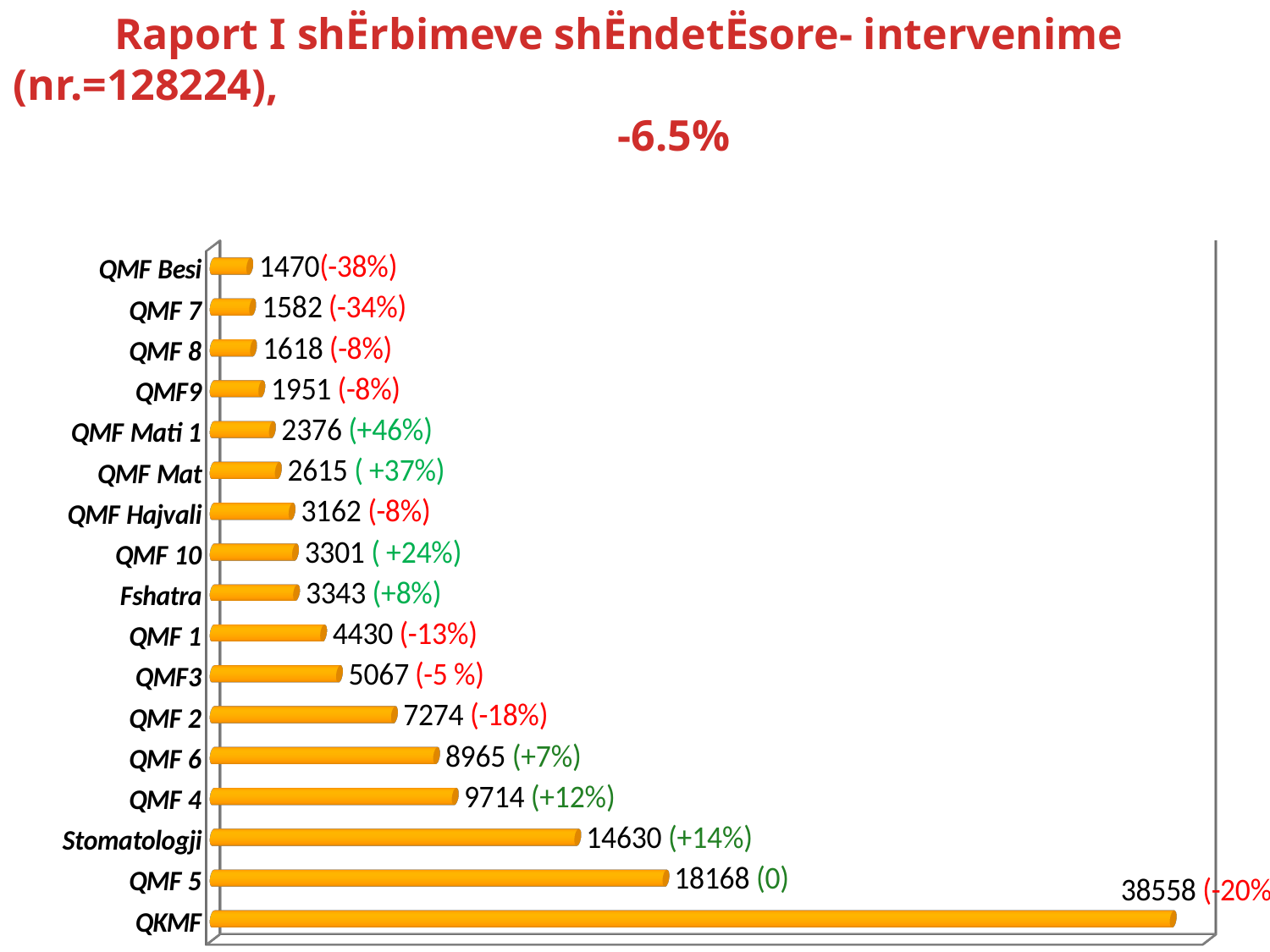
What kind of chart is this? Bar chart What is the value for QKMF? 38558 Which is larger, the value for QMF 6 or the value for QMF 2? QMF 6 What is the value for QMF Hajvali? 3162 What overall percentage change is shown in the slide title? -6.5% Which category has the highest value? QKMF What is the difference between the values for QMF 5 and QMF 4? 8454 What is the value for Stomatologji? 14630 What is the difference between the values for QMF 7 and QMF Besi? 112 How many categories are shown in the chart? 17 What percentage change is shown next to QMF Mati 1? +46% Which category has the lowest value? QMF Besi